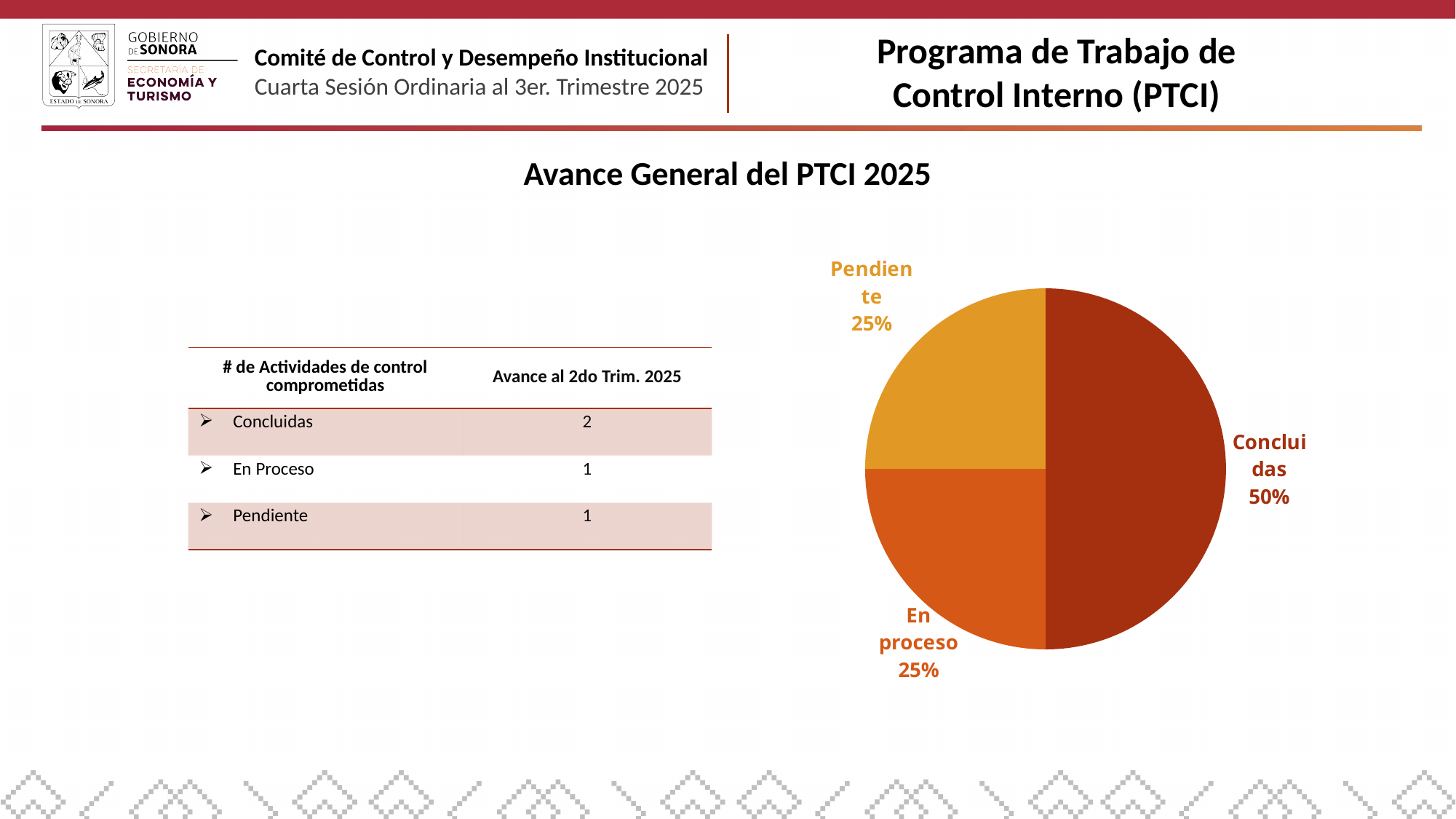
Which is larger in the pie chart, Concluidas or Pendiente? Concluidas What share of the pie does En proceso represent? 25% What is the difference in percentage points between the Concluidas slice and the En proceso slice? 25% What share of the pie does Concluidas represent? 50% What colour is the Pendiente slice of the pie chart? yellow-orange What kind of chart is shown on the slide? pie chart Which slice of the pie chart is the largest? Concluidas How many slices does the pie chart have? 3 What is the title shown above the chart and table? Avance General del PTCI 2025 What share of the pie does Pendiente represent? 25% Is the share for Concluidas greater or less than 40%? greater